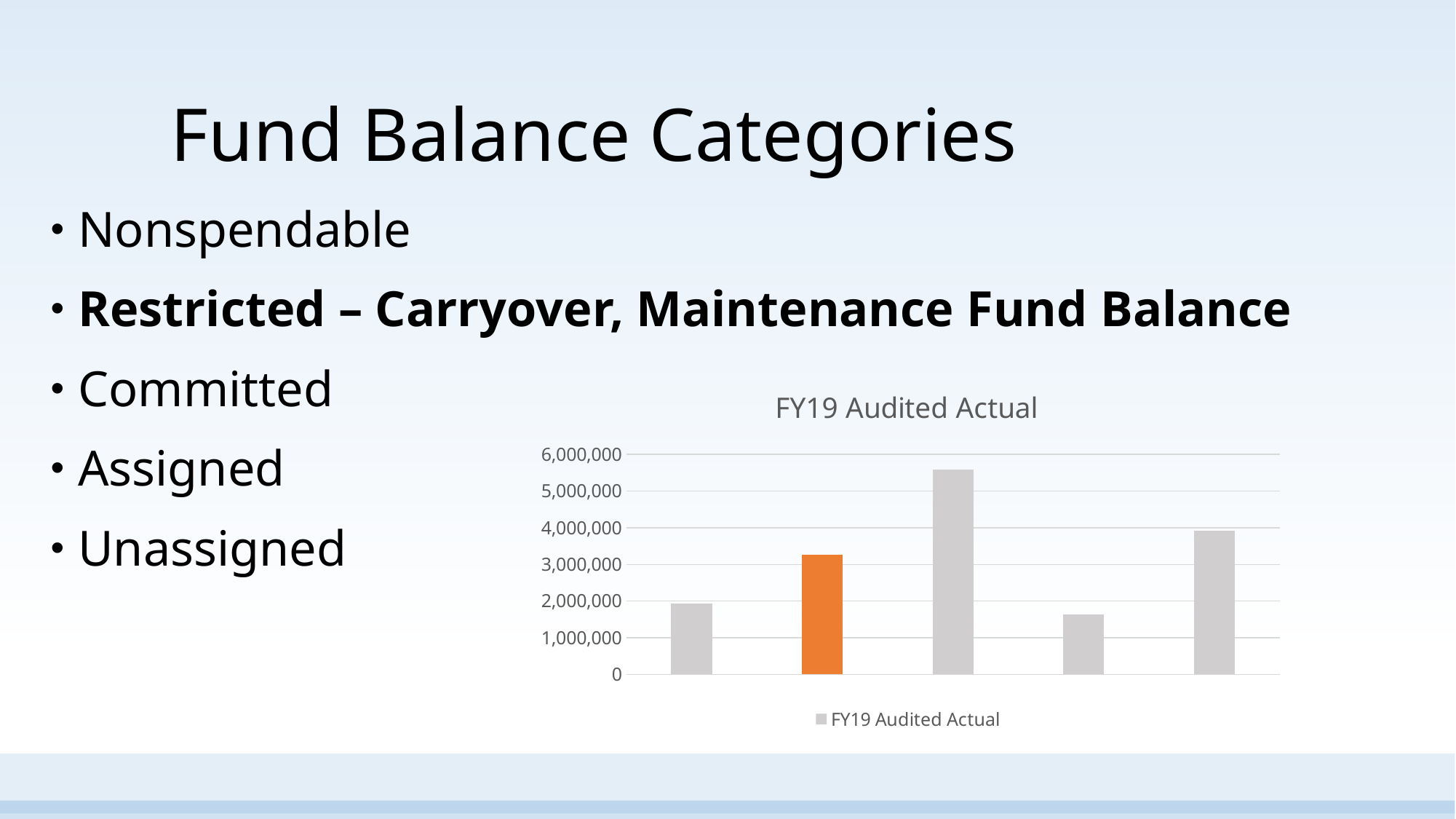
How many series does the chart legend list? 1 Is the value of the fourth bar greater or less than 2,000,000? less Is the value of the second (orange) bar greater or less than 3,000,000? greater What kind of chart is shown on the slide? bar chart Which bar in the chart is the tallest, counting from the left? the third bar Is the value of the third bar greater or less than 5,000,000? greater What is the title of the chart? FY19 Audited Actual Which is larger, the second bar or the fifth bar? the fifth bar Which bar, counting from the left, is coloured orange instead of grey? the second bar Which bar in the chart is the shortest, counting from the left? the fourth bar How many bars are plotted in the chart? 5